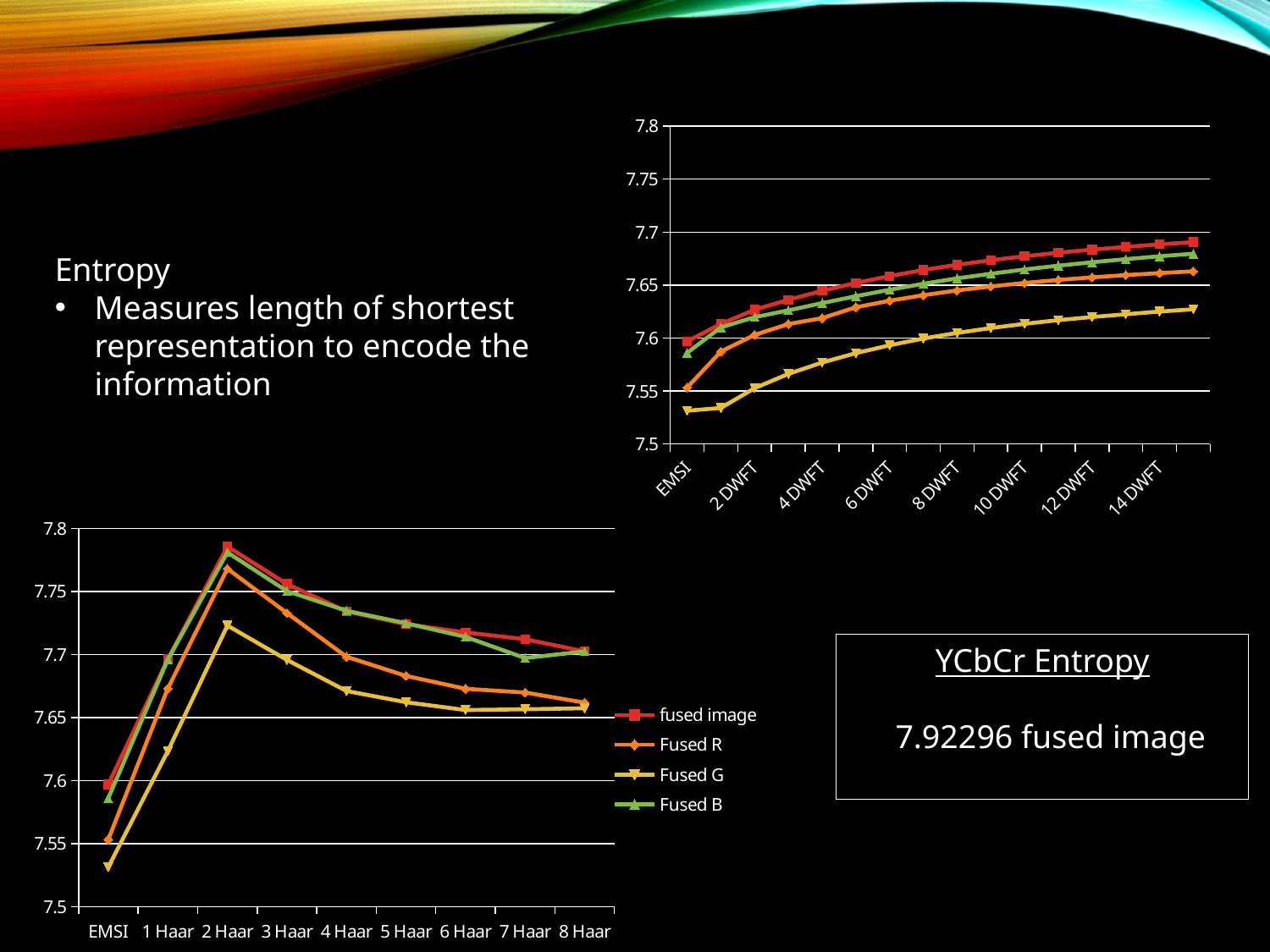
In the bottom-left Haar chart, is the value of Fused G at EMSI greater or less than 7.55? less In the bottom-left Haar chart, is the value of Fused G at 4 Haar greater or less than 7.65? greater In the top-right DWFT chart, is the value of Fused G at EMSI greater or less than 7.55? less What kind of chart is the bottom-left chart with the Haar categories? line chart How many series does the legend list? 4 In the top-right DWFT chart, do the values rise or fall from EMSI to 14 DWFT? rise In the top-right DWFT chart, which series has the highest value at 14 DWFT? fused image How many categories are on the x axis of the bottom-left Haar chart? 9 In the bottom-left Haar chart, at which category does the fused image series reach its highest value? 2 Haar In the bottom-left Haar chart, which series has the lowest values across all categories? Fused G